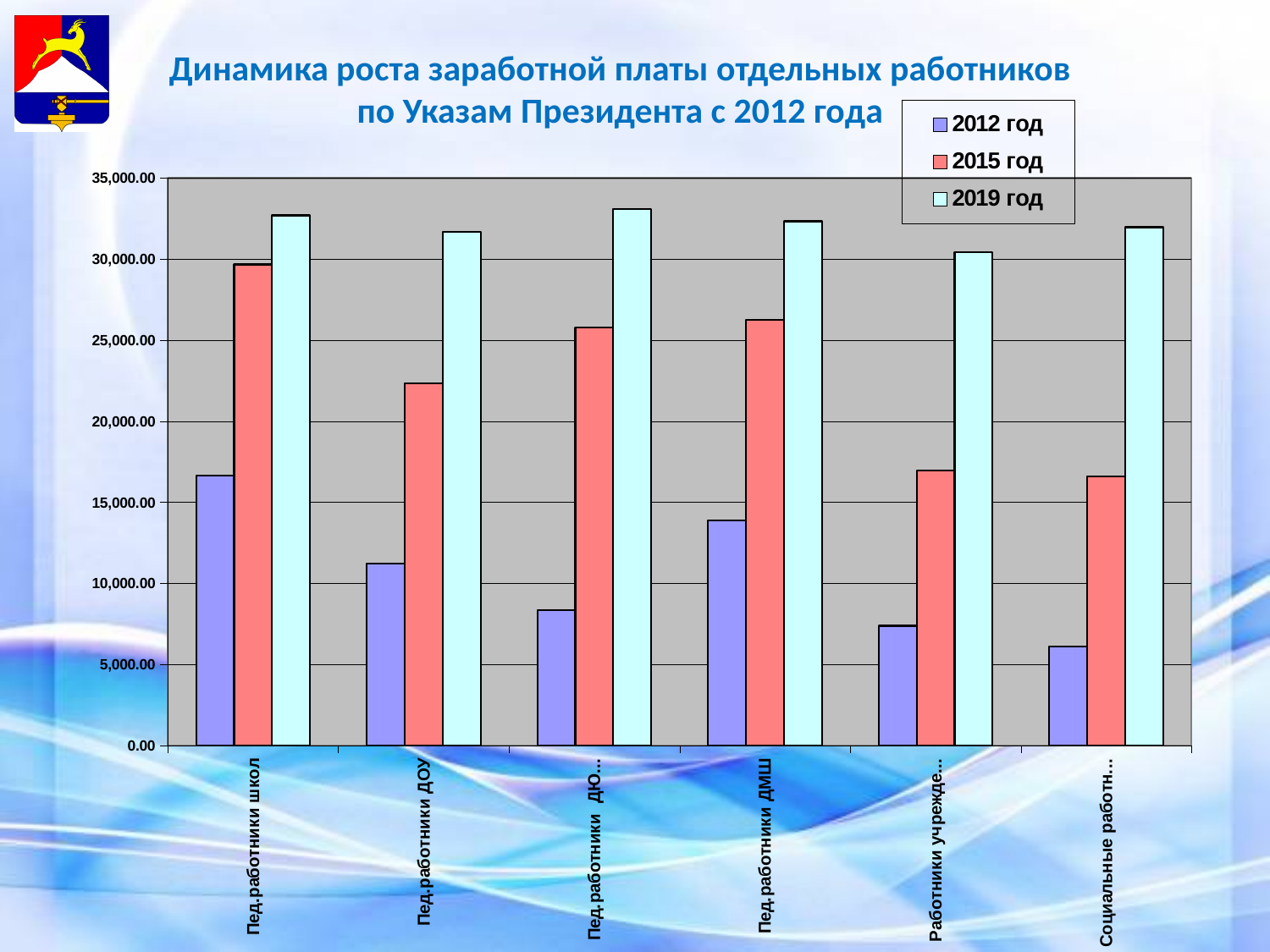
Is the 2012 год value for Пед.работники школ greater or less than 15,000.00? greater Is the 2019 год value for Пед.работники ДМШ greater or less than 30,000.00? greater For Пед.работники школ, do the values rise or fall from 2012 год to 2019 год? rise What kind of chart is shown on the slide? Bar chart Which colour represents the 2019 год series in the legend? Light blue Which is larger: the 2012 год value for Пед.работники ДМШ or the 2012 год value for Пед.работники ДОУ? Пед.работники ДМШ How many series does the legend list? 3 Which category has the highest value for 2012 год? Пед.работники школ Which category has the highest value for 2015 год? Пед.работники школ How many categories are shown along the x axis? 6 Is the 2015 год value for Пед.работники ДОУ greater or less than 25,000.00? less